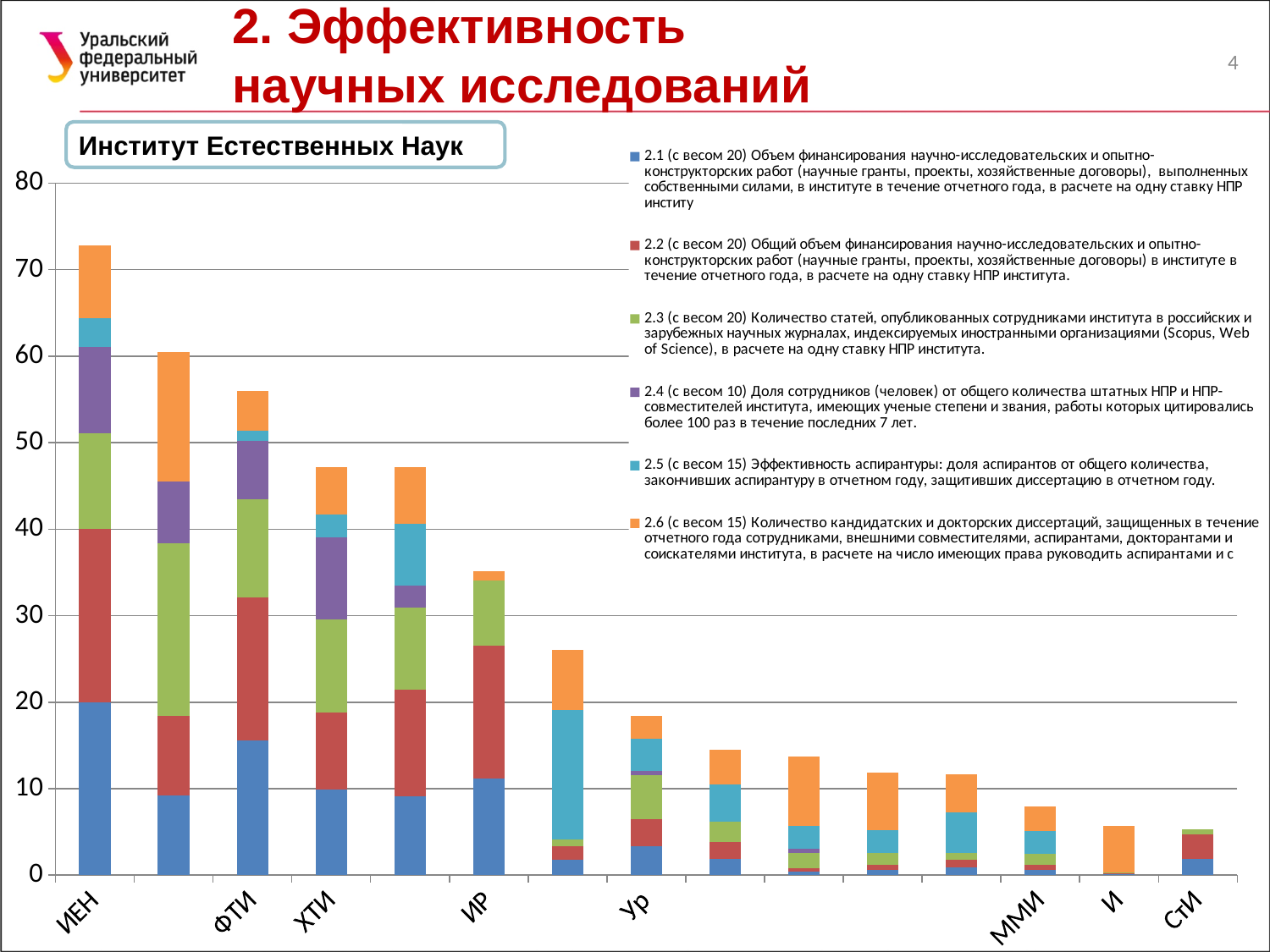
Is the total value for Ур greater or less than 20? less Is the total value for ИР greater or less than 30? greater What is the title shown in the box above the chart? Институт Естественных Наук Which has the larger total bar, ИЕН or ФТИ? ИЕН What kind of chart is shown on the slide? Stacked bar chart Do the total bar heights generally rise or fall from left to right along the x axis? fall Is the total value for ИЕН greater or less than 70? greater How many series does the legend list? 6 How many bars are plotted in the chart? 15 Which institute has the highest total bar? ИЕН